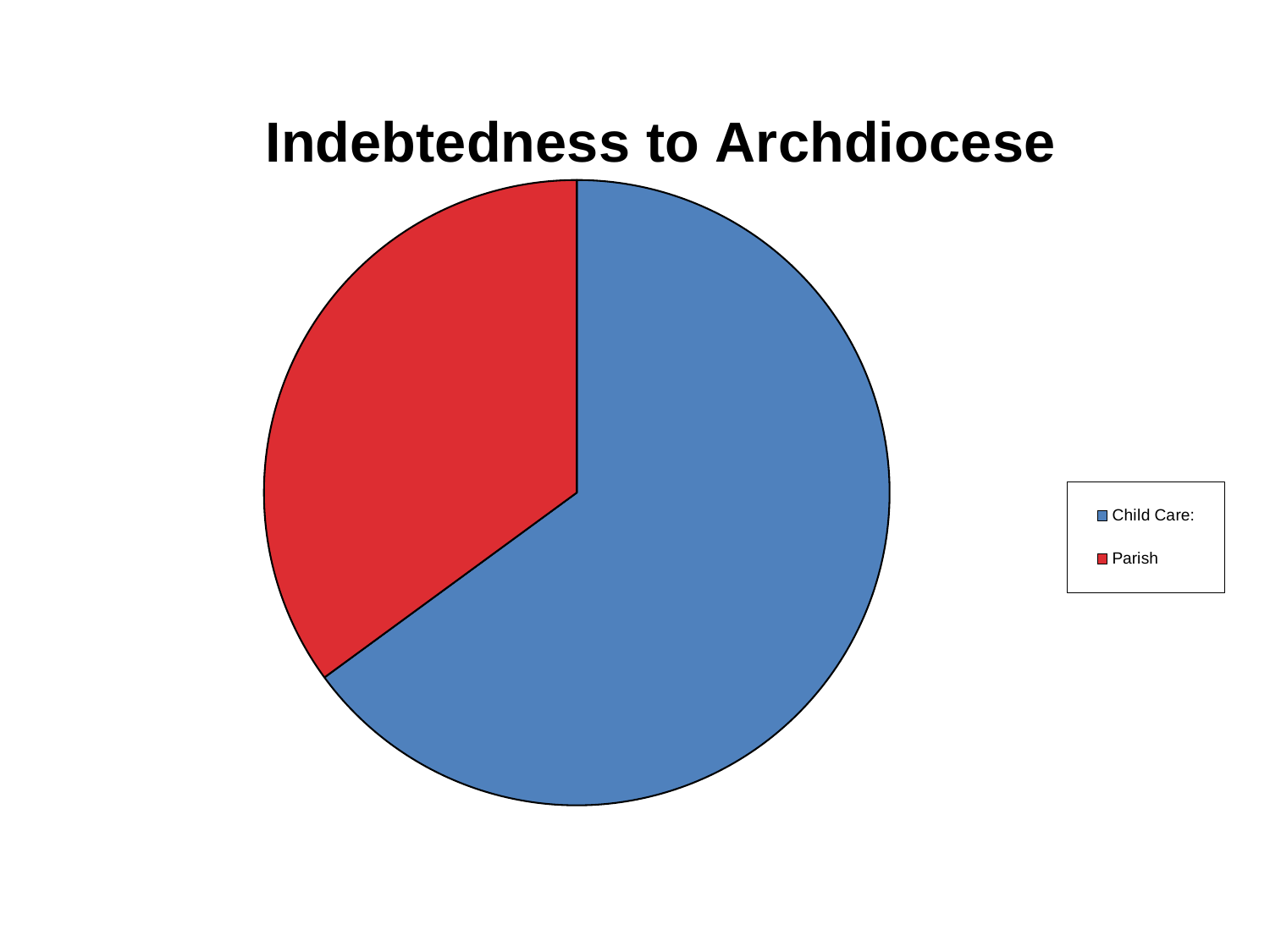
Which slice is larger, Child Care: or Parish? Child Care: Which category has the largest slice of the pie? Child Care: What is the title of the chart? Indebtedness to Archdiocese How many slices does the pie chart have? 2 How many entries does the legend list? 2 What kind of chart is shown on the slide? pie chart What colour is the Parish slice? red Which category has the smallest slice of the pie? Parish